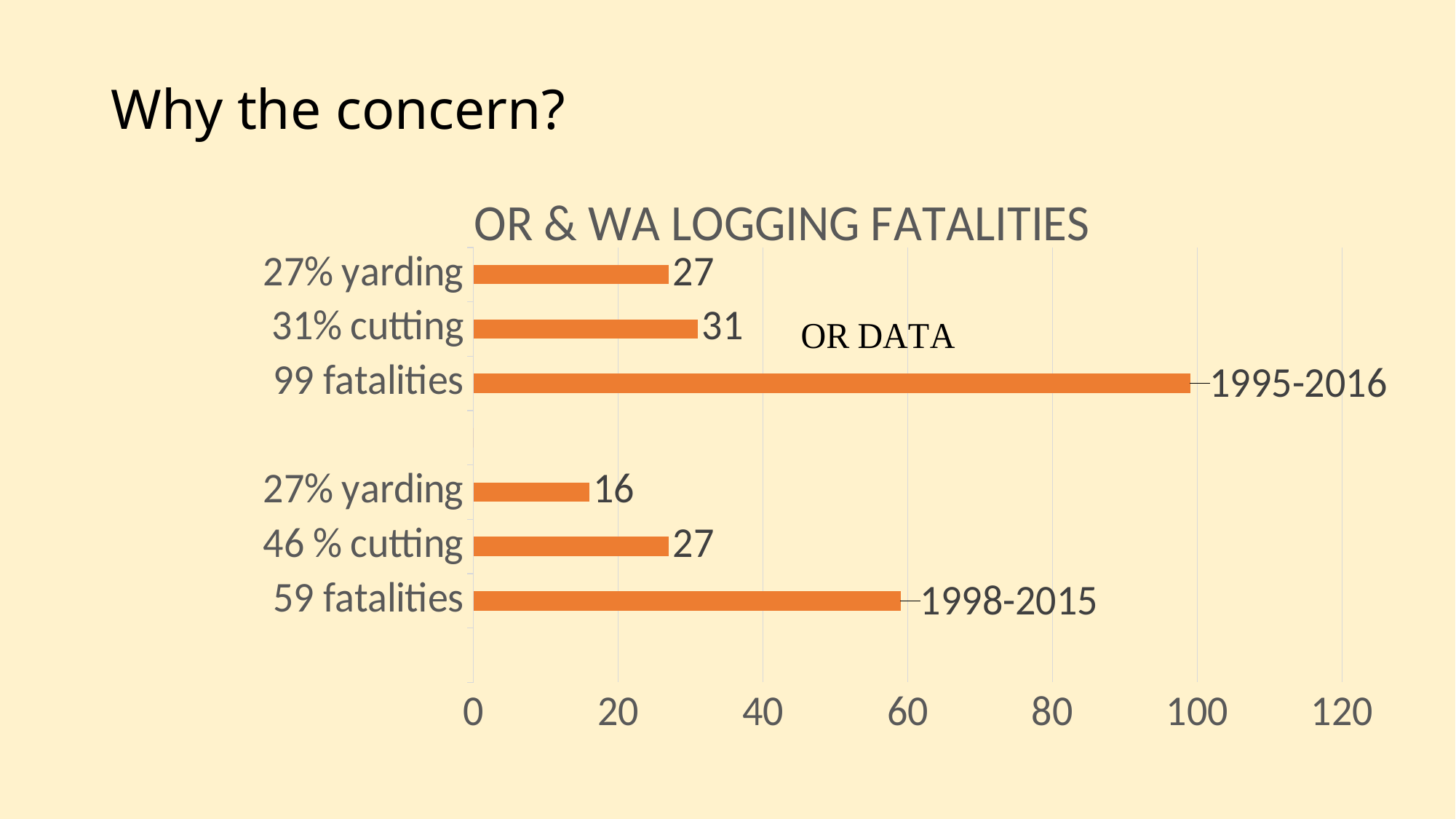
Is the value for "59 fatalities" greater or less than 40? greater What is the value of the "27% yarding" bar in the lower group (just above "46 % cutting")? 16 Which category has the longest bar? 99 fatalities What is the difference between the "31% cutting" bar and the "46 % cutting" bar? 4 What is the value of the bar for "31% cutting"? 31 What is the value of the bar for "46 % cutting"? 27 What is the value of the "27% yarding" bar at the top of the chart? 27 What label is printed at the end of the "99 fatalities" bar? 1995-2016 Which category has the shortest bar? 27% yarding (lower group, value 16) What label is printed at the end of the "59 fatalities" bar? 1998-2015 What is the title of the chart? OR & WA LOGGING FATALITIES What type of chart is shown on the slide? bar chart